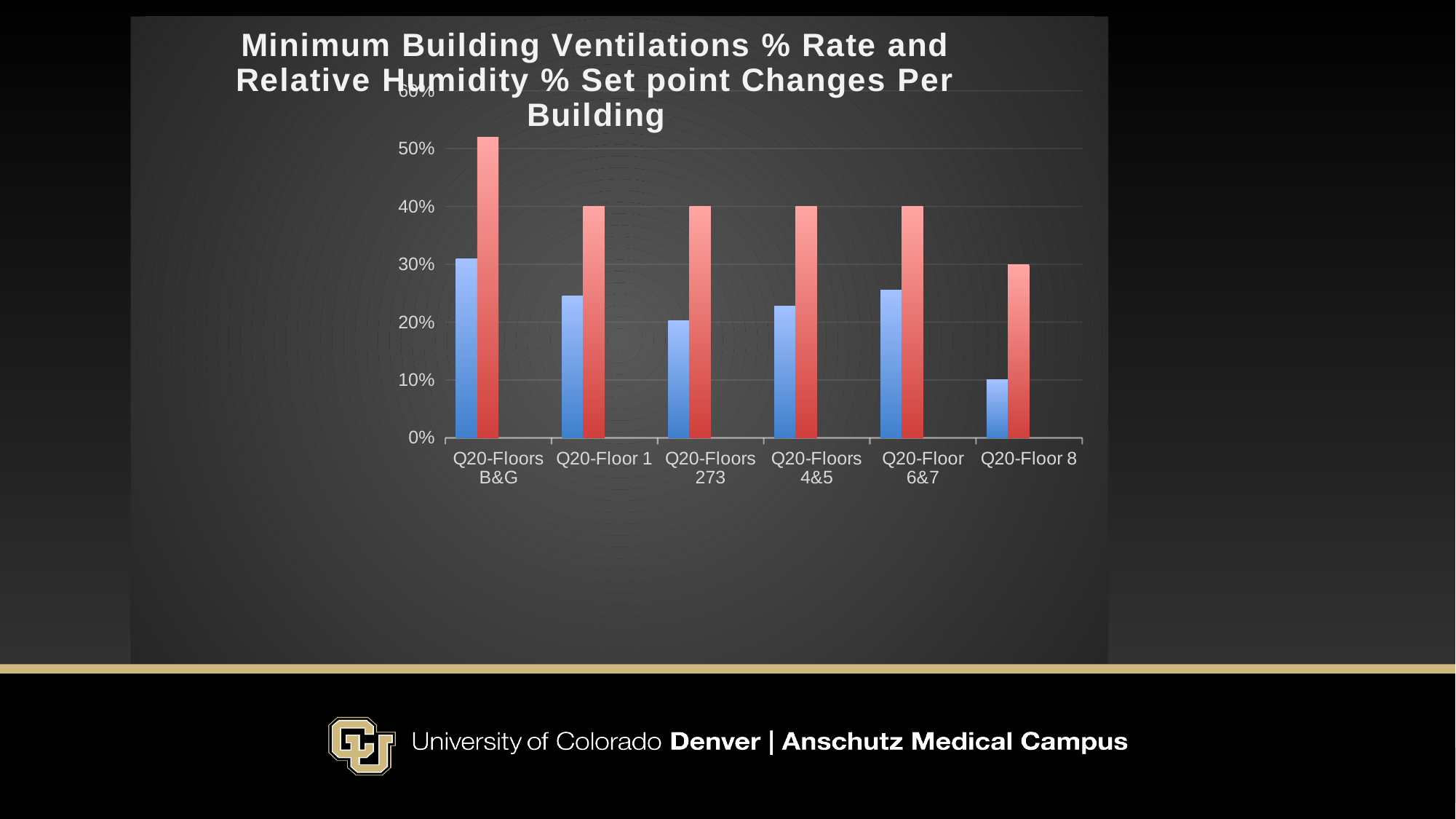
Is the value of the red bar for Q20-Floors B&G greater or less than 50%? greater What kind of chart is shown on the slide? bar chart What is the value of the blue bar for Q20-Floor 8? 10% How many categories are shown on the x axis of the chart? 6 Is the value of the blue bar for Q20-Floor 1 greater or less than 30%? less For Q20-Floors 4&5, which bar is larger, the blue bar or the red bar? the red bar What is the value of the red bar for Q20-Floor 8? 30% What is the difference between the red bar and the blue bar for Q20-Floor 8? 20% What is the value of the red bar for Q20-Floor 1? 40% Which category has the highest red bar? Q20-Floors B&G Which category has the lowest blue bar? Q20-Floor 8